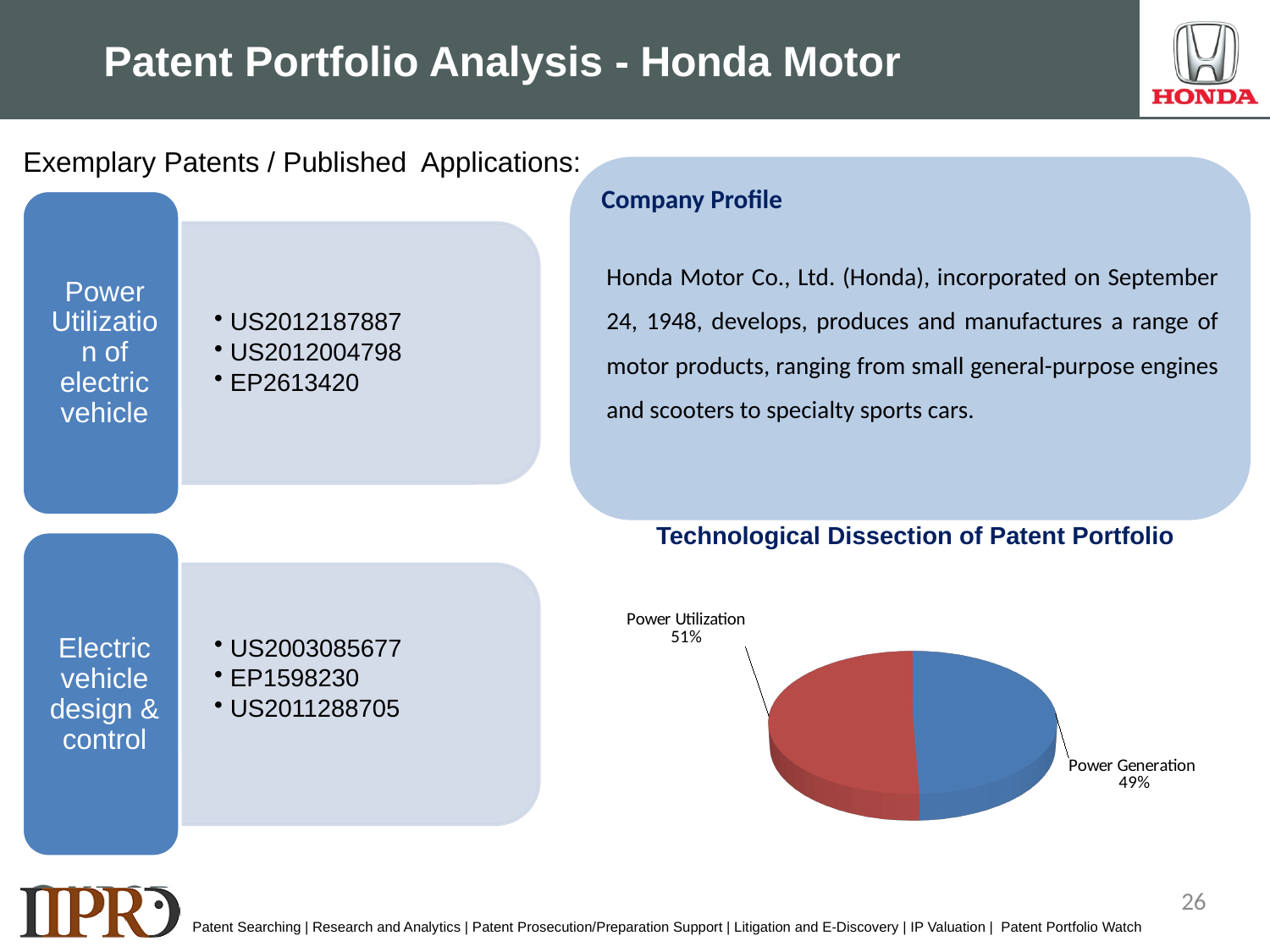
What share of the pie chart does Power Generation represent? 49% What colour is the Power Generation slice in the pie chart? Blue What share of the pie chart does Power Utilization represent? 51% Which slice of the pie chart is the largest? Power Utilization What is the title of the pie chart on the slide? Technological Dissection of Patent Portfolio Which is larger in the pie chart, Power Utilization or Power Generation? Power Utilization What is the difference in percentage points between the Power Utilization and Power Generation slices? 2 How many slices does the pie chart have? 2 What type of chart is shown under the title "Technological Dissection of Patent Portfolio"? Pie chart Which slice of the pie chart is the smallest? Power Generation Is the share for Power Generation greater or less than 50%? less